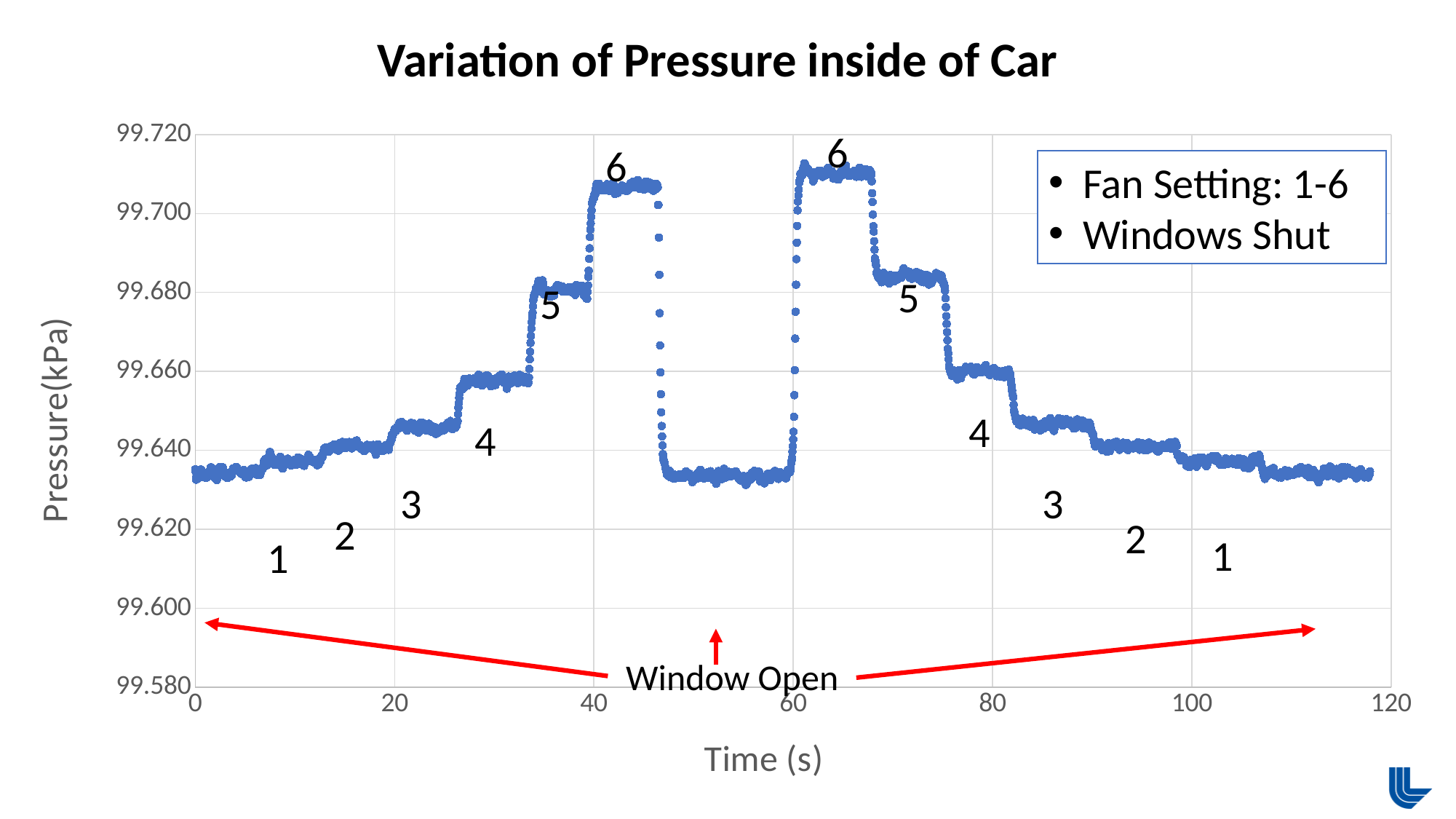
What is the label of the y axis? Pressure(kPa) What is the title of the chart? Variation of Pressure inside of Car What kind of chart is shown on the slide? scatter chart Which is larger, the pressure at fan setting 6 around 45 s or the pressure at fan setting 6 around 65 s? fan setting 6 around 65 s Does the pressure rise or fall as time goes from 65 s to 118 s? fall Is the pressure at fan setting 1 (around 5 s) greater or less than 99.640? less Is the pressure at fan setting 3 (around 22 s) greater or less than 99.640? greater Is the pressure while the window is open (around 50 s) greater or less than 99.640? less Which fan setting gives the highest pressure? 6 Does the pressure rise or fall as time goes from 0 s to 45 s? rise